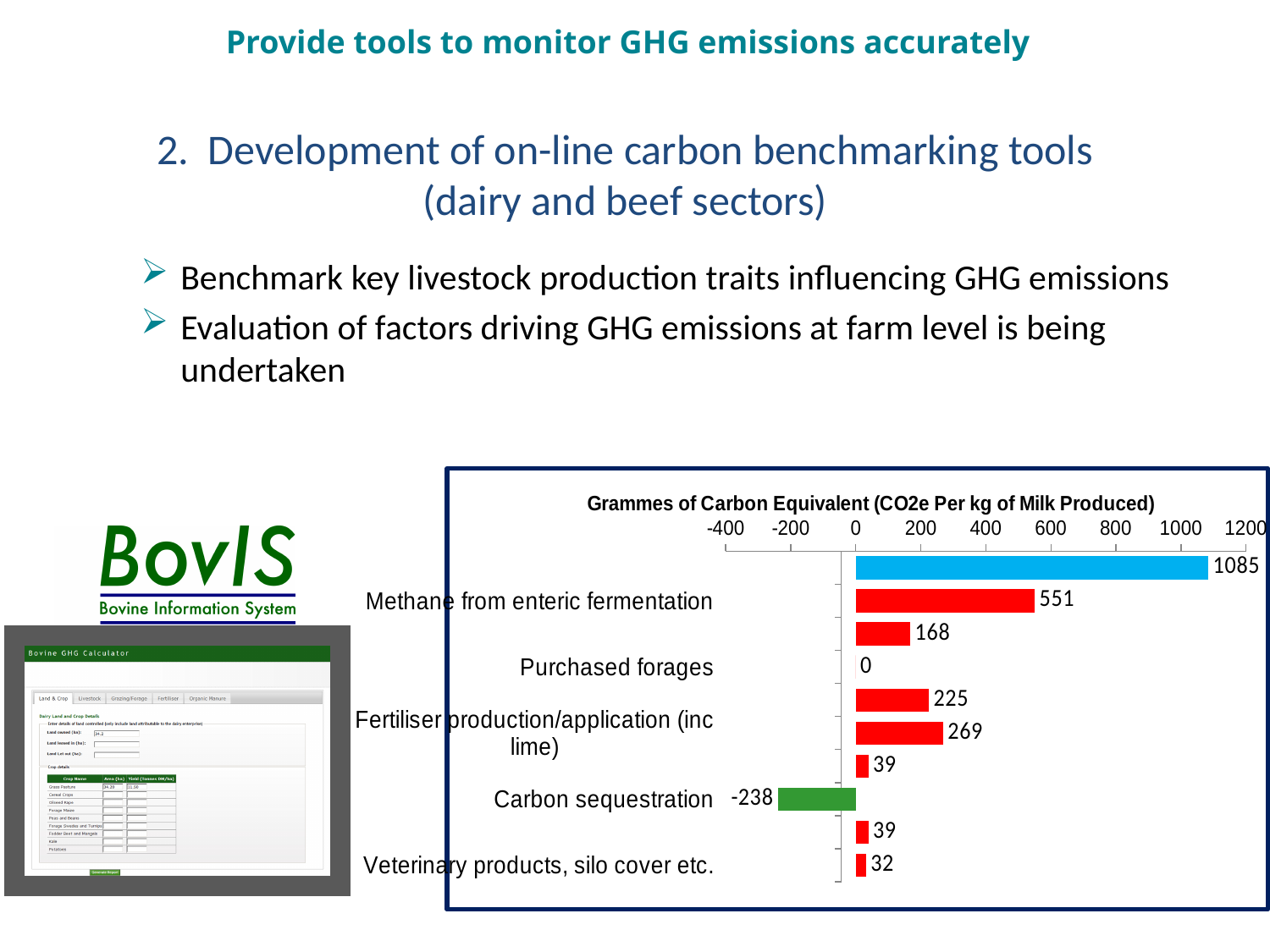
What is the value for Veterinary products, silo cover etc.? 32 Is the value for Methane from enteric fermentation greater or less than 400? greater What is the value for Purchased forages? 0 What is the largest value shown on the chart? 1085 How many bars are plotted on the chart? 10 What is the value for Methane from enteric fermentation? 551 What is the value for Fertiliser production/application (inc lime)? 269 What type of chart is shown? Bar chart Which labelled category has the lowest value? Carbon sequestration Which is larger, the value for Methane from enteric fermentation or the value for Veterinary products, silo cover etc.? Methane from enteric fermentation What is the difference between the values for Methane from enteric fermentation and Fertiliser production/application (inc lime)? 282 What is the value for Carbon sequestration? -238